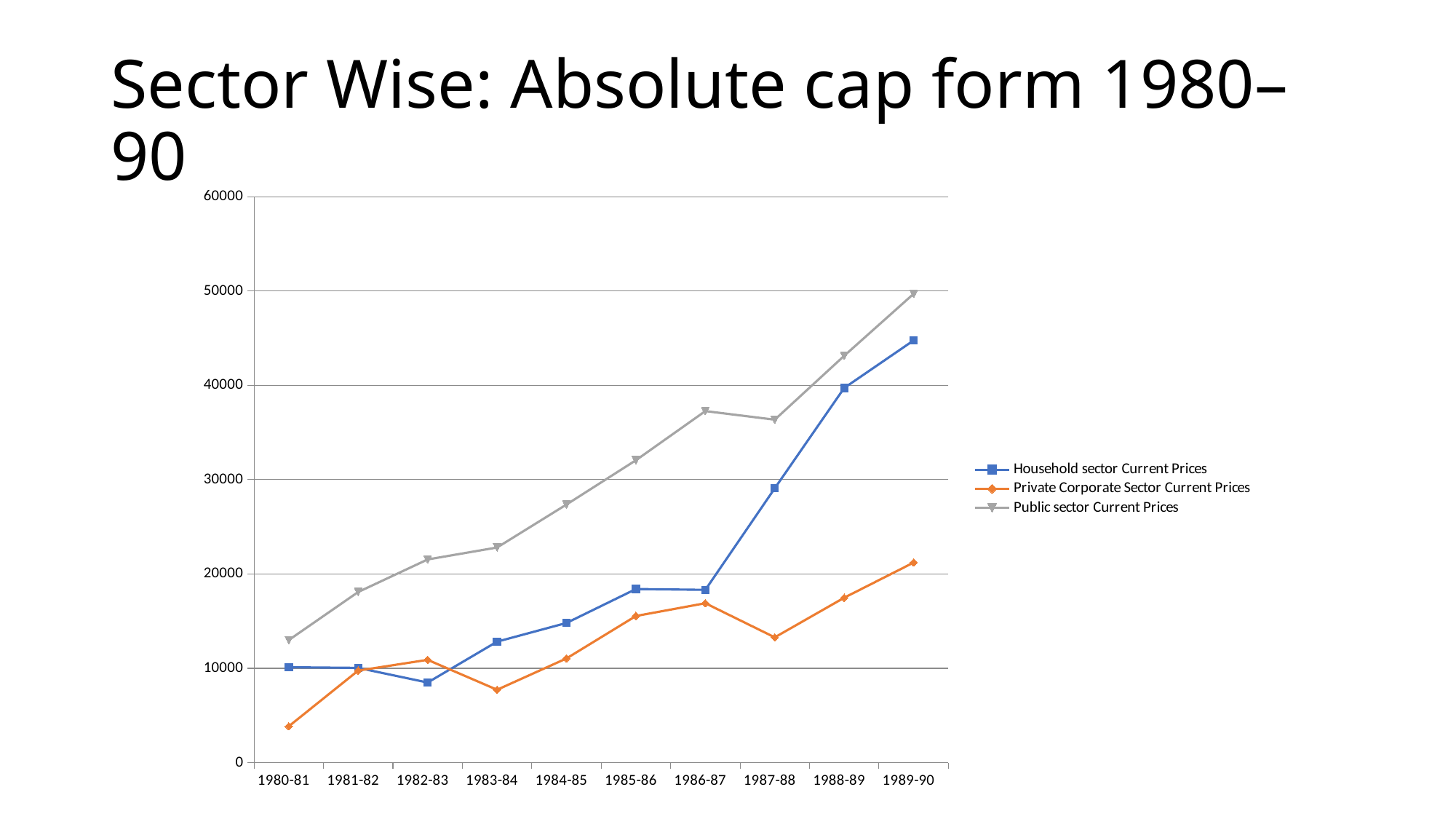
Is the value for Private Corporate Sector Current Prices in 1983-84 greater or less than 10000? less In 1987-88, which is larger: Household sector Current Prices or Private Corporate Sector Current Prices? Household sector Current Prices Does the Public sector Current Prices series rise or fall from 1980-81 to 1989-90? rise In which year is the Private Corporate Sector Current Prices series at its lowest? 1980-81 Which series is drawn with the orange line? Private Corporate Sector Current Prices What kind of chart is shown on the slide? line chart Is the value for Public sector Current Prices in 1989-90 greater or less than 40000? greater Which series has the highest value in 1989-90? Public sector Current Prices How many years are shown along the x axis? 10 How many series does the legend list? 3 Is the value for Household sector Current Prices in 1987-88 greater or less than 20000? greater Which series has the lowest value in 1980-81? Private Corporate Sector Current Prices